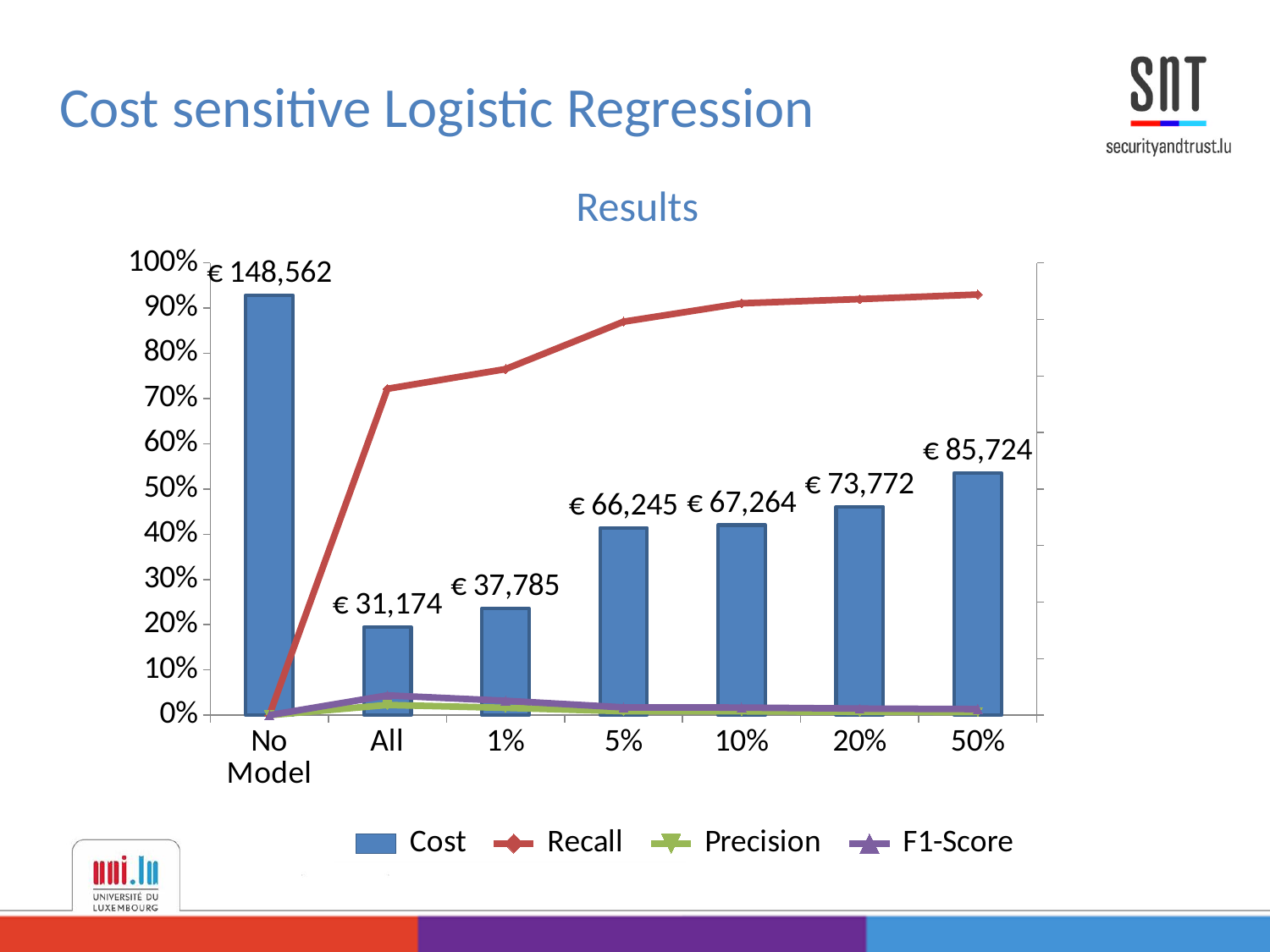
How many categories are shown on the x axis? 7 Is the Recall value for the 1% category greater or less than 80%? less What is the difference in Cost between the 20% category and the 10% category? € 6,508 Which has the larger Cost, the 5% category or the 1% category? 5% What is the Cost value for the No Model category? € 148,562 What is the Cost value for the 50% category? € 85,724 Is the Recall value for the 50% category greater or less than 90%? greater Which category has the highest Cost? No Model Which category has the lowest Cost? All What is the Cost value for the All category? € 31,174 How many series does the legend list? 4 Which series is plotted as bars? Cost